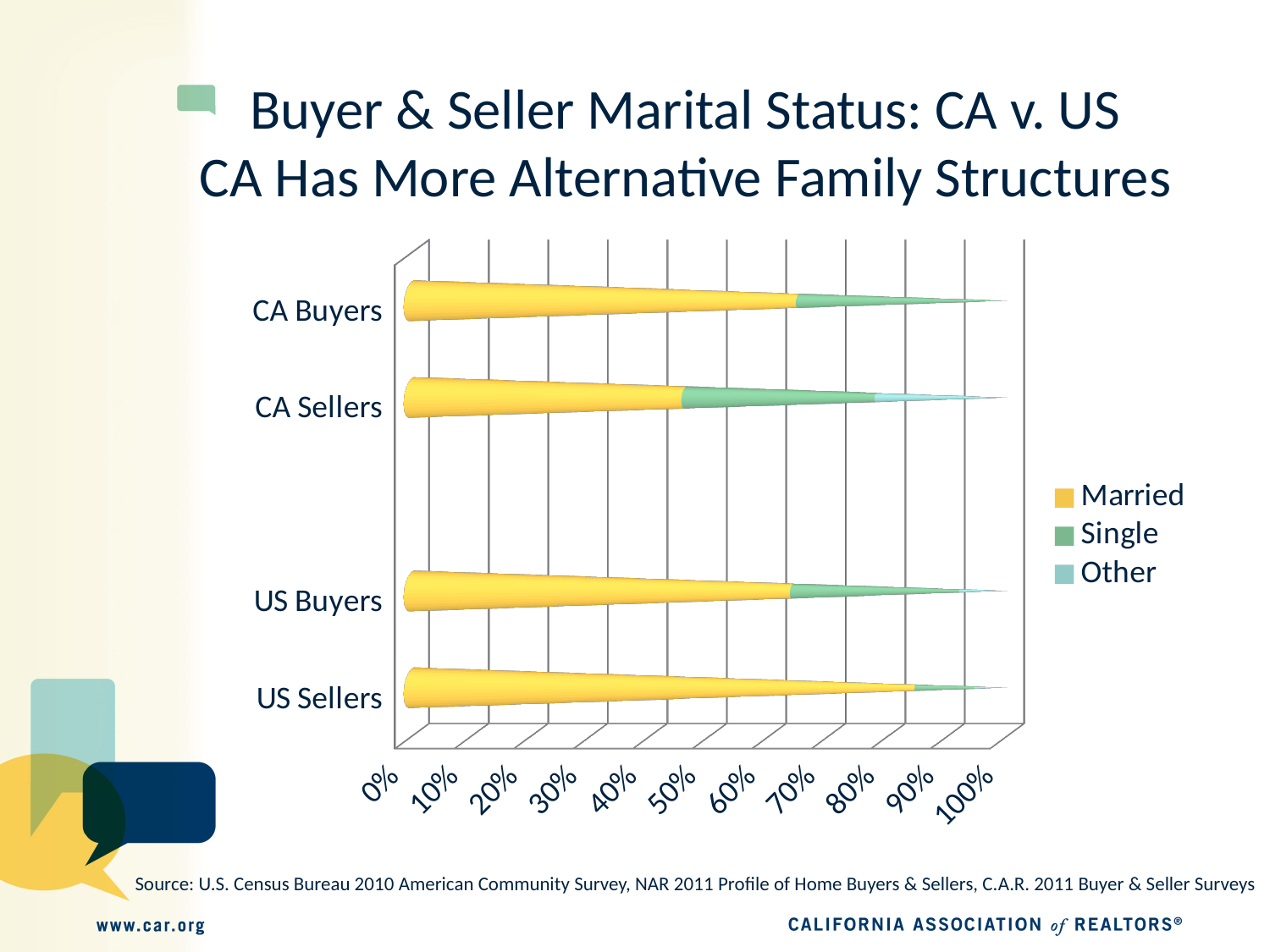
Which category has the largest Single segment? CA Buyers How many series does the legend list? 3 How many categories are shown on the chart? 4 What kind of chart is shown on the slide? bar chart Which category has the lowest Married share? CA Sellers Which series are listed in the legend? Married, Single, Other Which category has the highest Married share? US Sellers What is the highest value shown on the horizontal axis? 100% Is the Married value for CA Sellers greater or less than 50%? less Is the Married value for US Sellers greater or less than 80%? greater Which is larger, the Married share for US Sellers or for CA Sellers? US Sellers Is the Married value for CA Buyers greater or less than 60%? greater